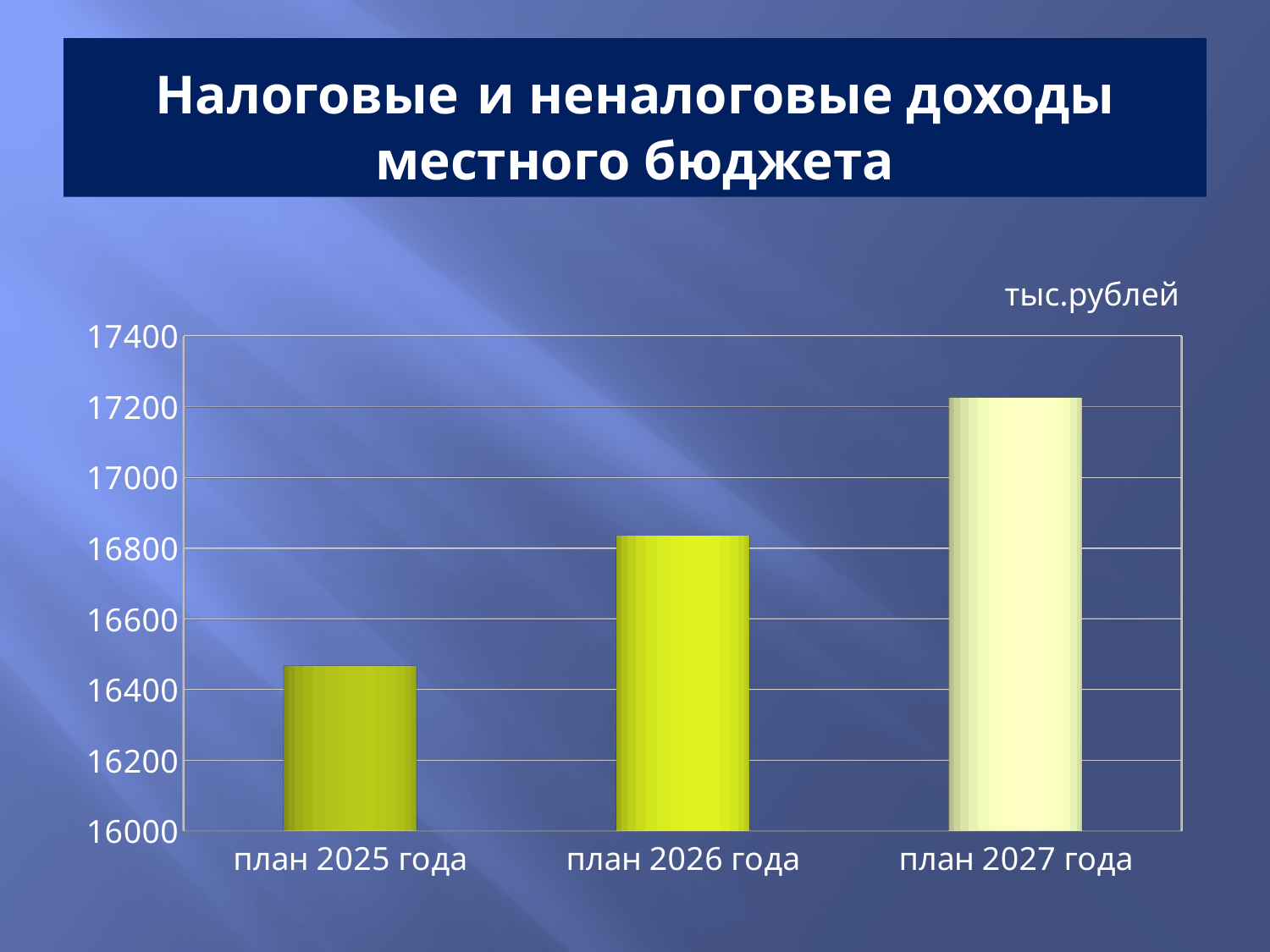
Which category has the highest value in the chart? план 2027 года Is the value for план 2026 года greater or less than 17000? less Which is larger: the value for план 2026 года or the value for план 2025 года? план 2026 года Which category has the lowest value in the chart? план 2025 года Is the value for план 2025 года greater or less than 16400? greater Do the values rise or fall from план 2025 года to план 2027 года? rise What kind of chart is shown on the slide? bar chart Which is larger: the value for план 2026 года or the value for план 2027 года? план 2027 года How many categories are shown on the x axis of the chart? 3 Is the value for план 2025 года greater or less than 16600? less What unit of measurement is indicated above the chart? тыс.рублей